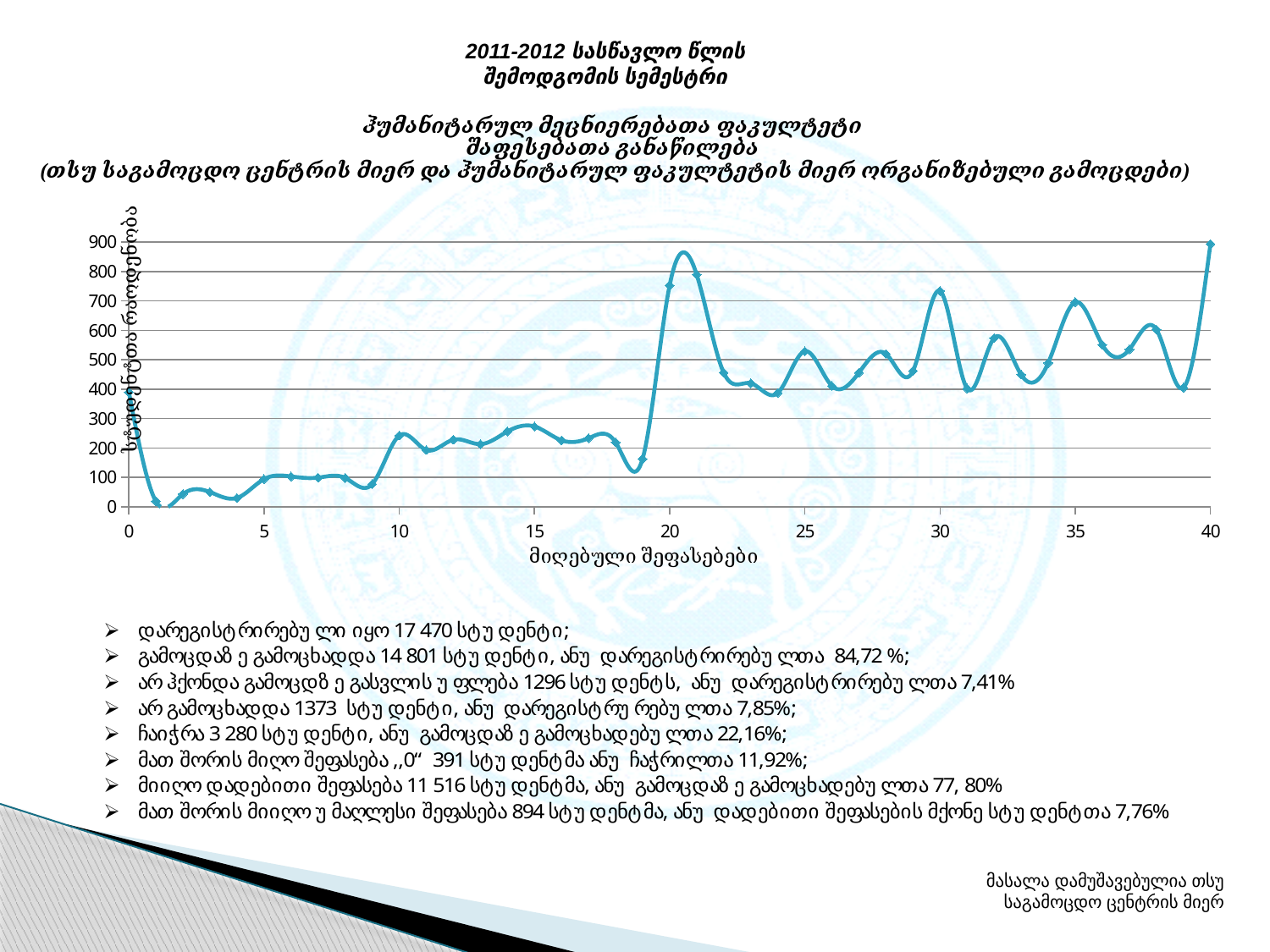
Do the values rise or fall between grade 19 and grade 21? rise Which has more students: grade 10 or grade 20? grade 20 Is the value for grade 10 greater or less than 200? greater Is the value for grade 30 greater or less than 600? greater Is the value for grade 40 greater or less than 800? greater What is the label of the x axis? მიღებული შეფასებები Which grade on the x axis has the lowest number of students? 1 What kind of chart is shown on the slide? line chart What is the highest tick value shown on the y axis? 900